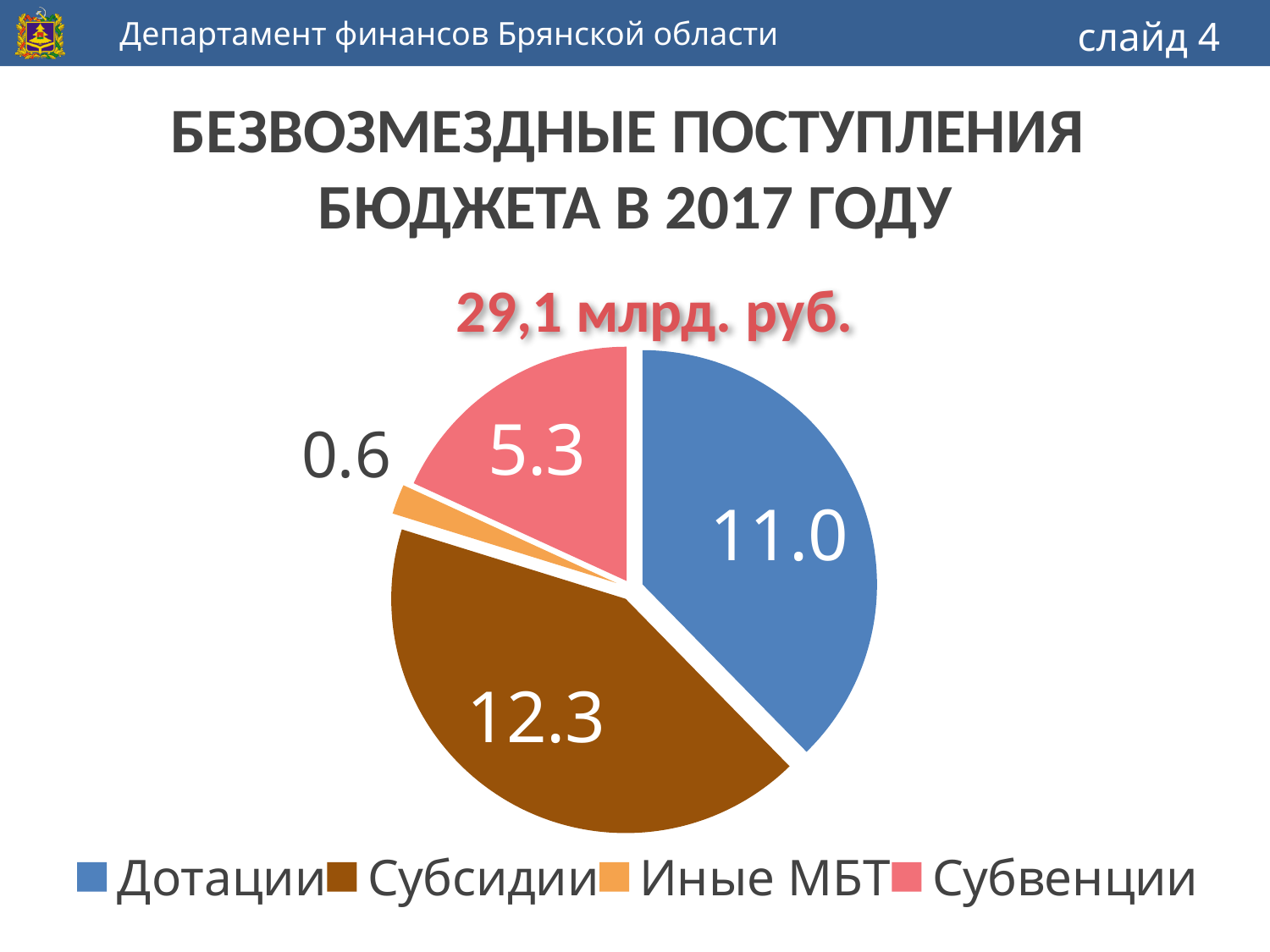
What is the difference between the values for Дотации and Субвенции? 5.7 What is the value for Дотации? 11.0 How many categories does the pie chart have? 4 What is the value for Субвенции? 5.3 What total amount is printed above the pie chart? 29,1 млрд. руб. What is the value for Субсидии? 12.3 What type of chart is shown on the slide? pie chart What is the difference between the values for Субсидии and Дотации? 1.3 What is the value for Иные МБТ? 0.6 Which category has the largest slice of the pie? Субсидии Which is larger, Субвенции or Дотации? Дотации Which category has the smallest slice of the pie? Иные МБТ